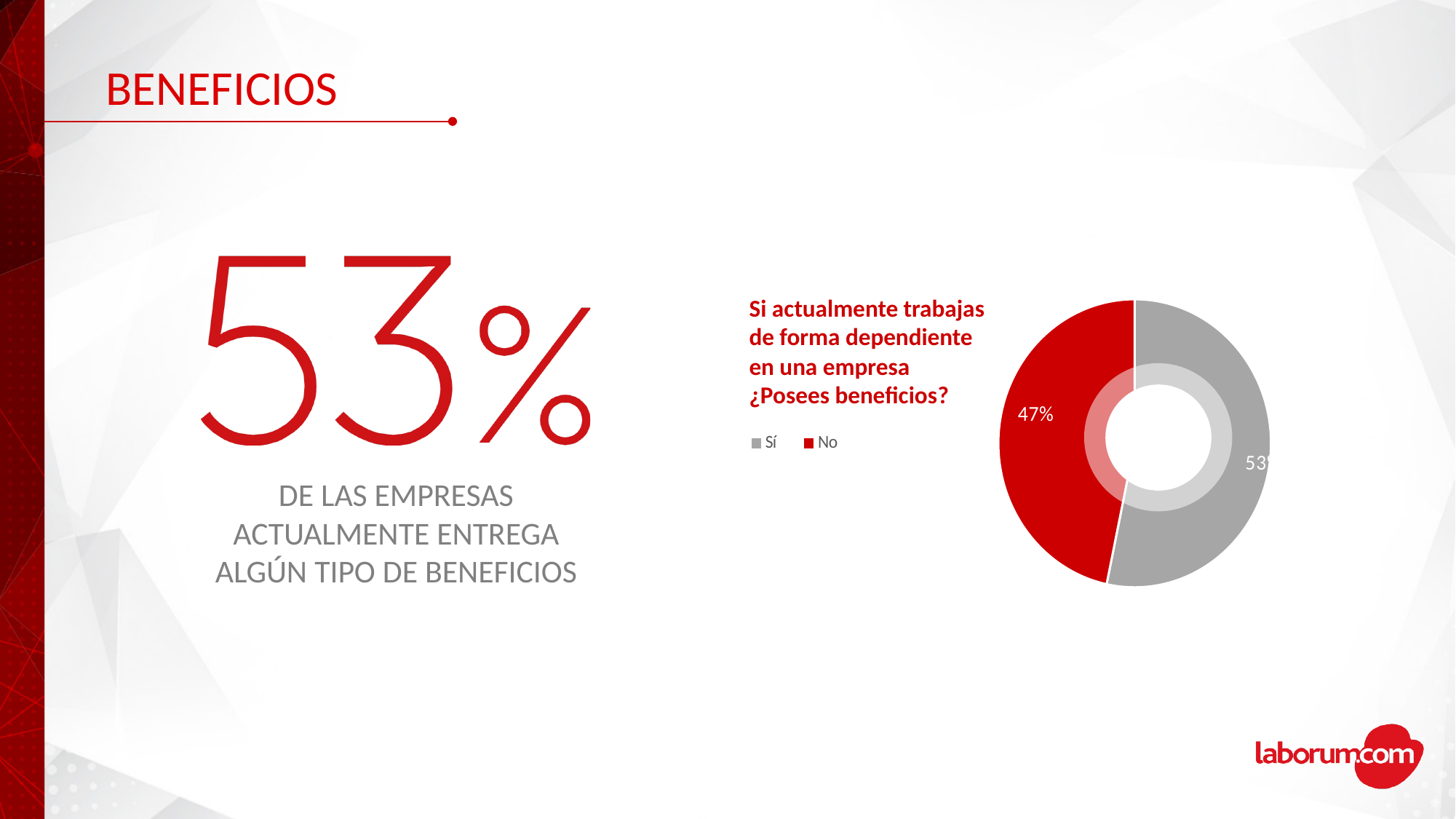
What kind of chart is shown on the slide? doughnut chart How many entries does the chart legend list? 2 How many slices does the doughnut chart have? 2 Is the share for "Sí" larger or smaller than the share for "No"? larger In the doughnut chart, what percentage of respondents answered "No"? 47% Which response has the smaller share in the doughnut chart? No What question does the doughnut chart answer, according to its title? Si actualmente trabajas de forma dependiente en una empresa ¿Posees beneficios? What colour represents "No" in the doughnut chart? red By how many percentage points does "Sí" exceed "No" in the doughnut chart? 6 percentage points Which response has the larger share in the doughnut chart? Sí What do the two slices of the doughnut chart add up to? 100% In the doughnut chart, what percentage of respondents answered "Sí"? 53%